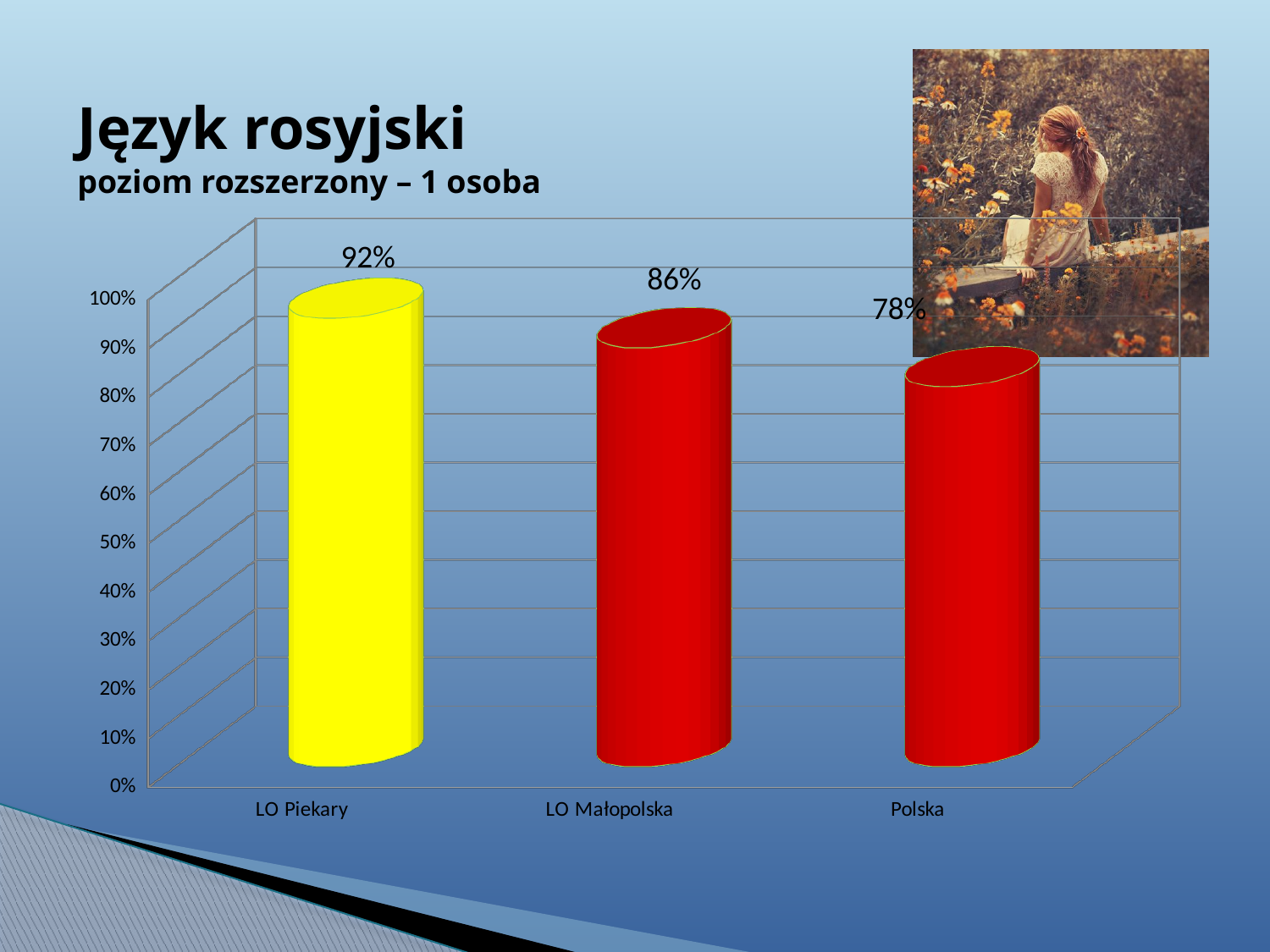
What is the value for LO Małopolska? 86% Do the values rise or fall from left to right across the categories? fall What kind of chart is shown on the slide? bar chart What is the difference between the values for LO Piekary and Polska? 14% Which category has the highest value? LO Piekary Which category has the lowest value? Polska What is the value for LO Piekary? 92% What is the difference between the values for LO Małopolska and Polska? 8% Which is larger, the value for LO Piekary or the value for LO Małopolska? LO Piekary How many categories are shown on the chart? 3 What is the value for Polska? 78% Is the value for Polska greater or less than 80%? less